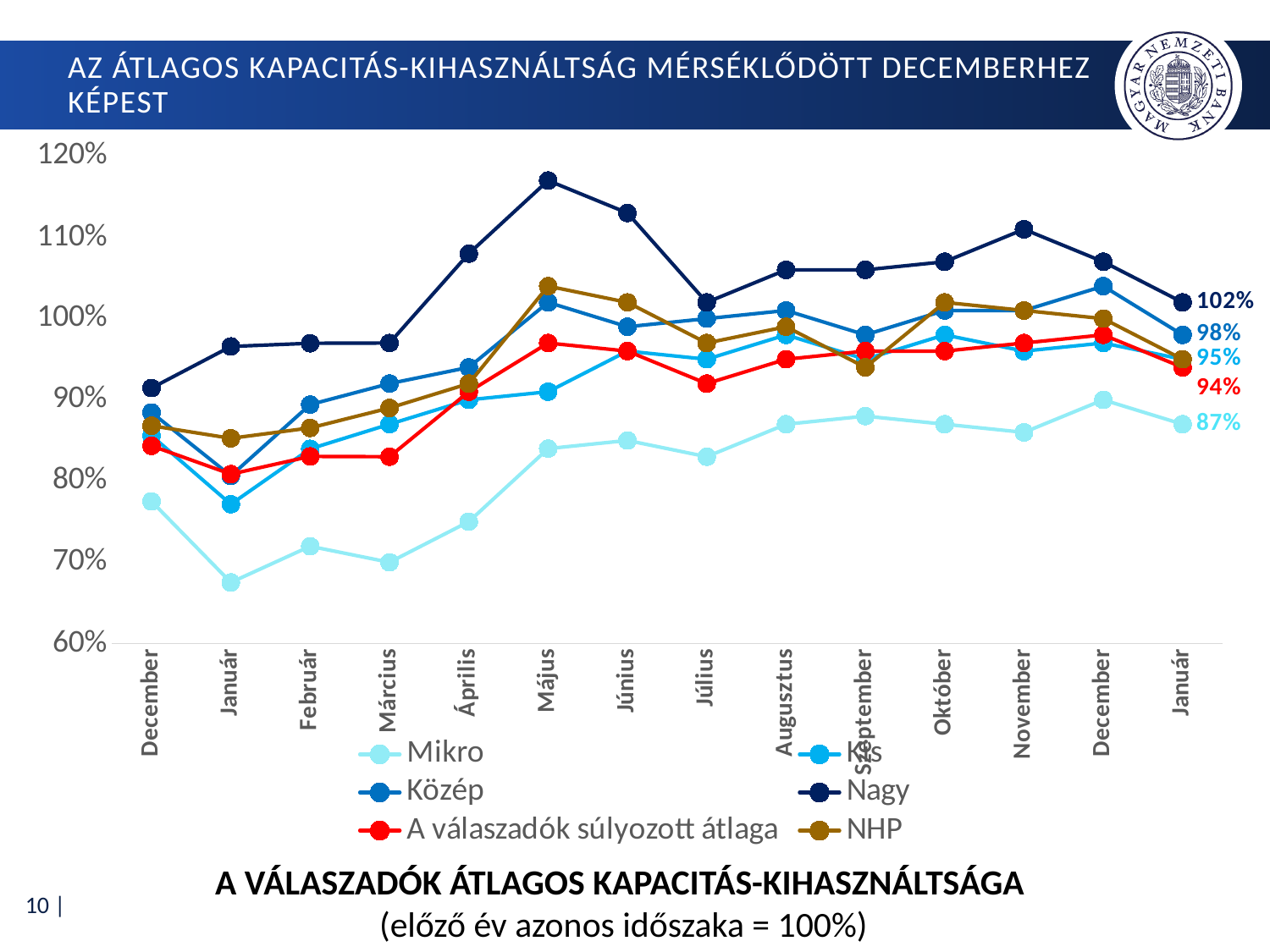
How many series does the legend list? 6 Is the value for Mikro in the first Január greater or less than 70%? less Which series has the highest value at the final Január point? Nagy What is the value for A válaszadók súlyozott átlaga at the final Január point? 94% What is the value for Mikro at the final Január point? 87% How many months are plotted along the x axis? 14 What type of chart is shown on the slide? line chart Which series has the lowest value at the final Január point? Mikro What is the value for Nagy at the final Január point? 102% What is the difference between the Nagy and Mikro values at the final Január point? 15 percentage points What is the value for Közép at the final Január point? 98% Is the value for Nagy in Május greater or less than 110%? greater